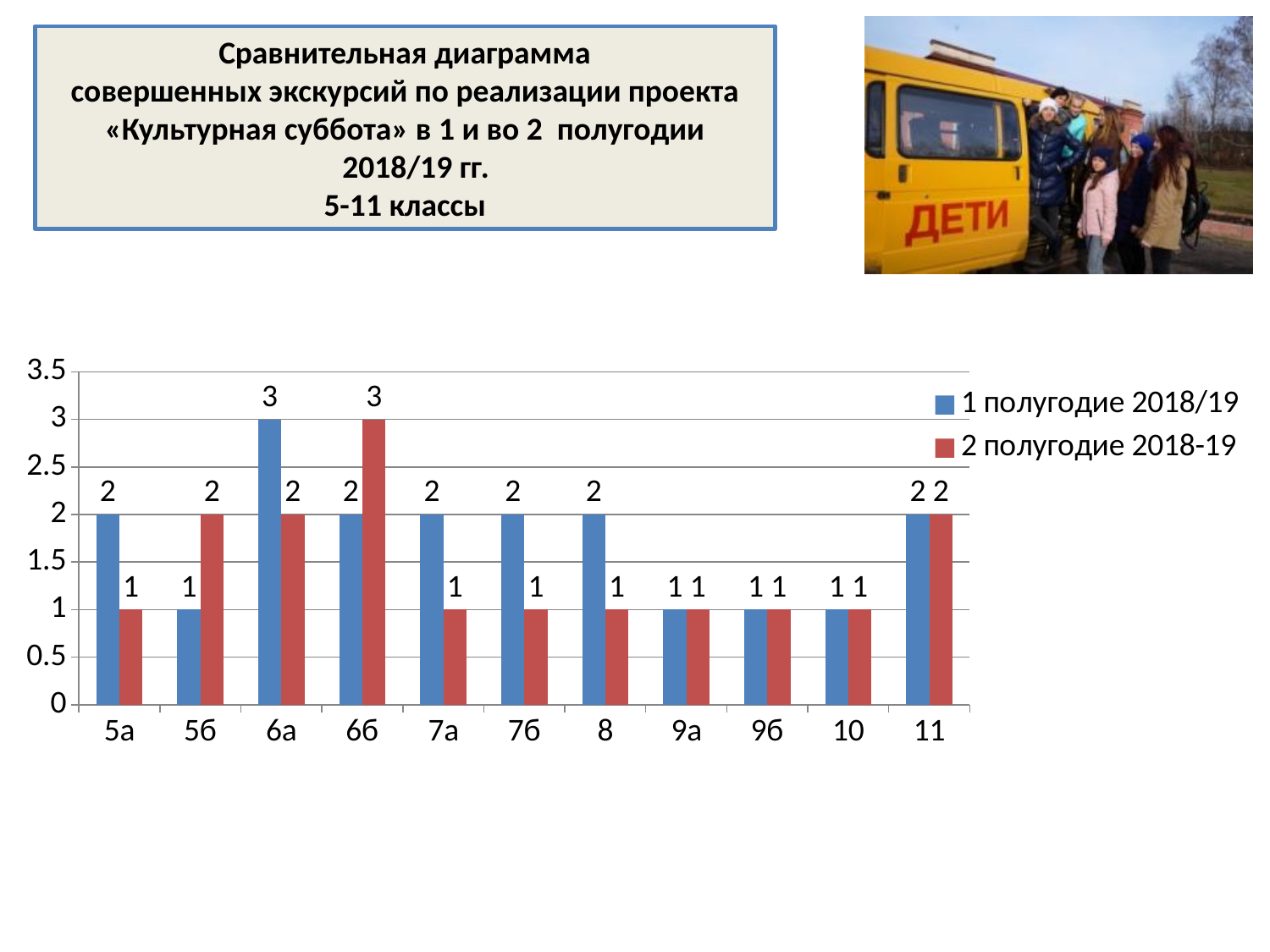
Is the value for 6а in the series "1 полугодие 2018/19" greater or less than 2.5? greater What kind of chart is shown on the slide? bar chart Which category has the highest value in the series "2 полугодие 2018-19"? 6б What is the value for 6а in the series "1 полугодие 2018/19"? 3 What is the total of the two series values for 11? 4 How many series does the legend list? 2 For 5б, which series has the larger value: "1 полугодие 2018/19" or "2 полугодие 2018-19"? 2 полугодие 2018-19 Which category has the highest value in the series "1 полугодие 2018/19"? 6а What is the value for 6б in the series "2 полугодие 2018-19"? 3 How many categories are shown on the x axis? 11 What is the value for 5б in the series "1 полугодие 2018/19"? 1 What is the difference between the "1 полугодие 2018/19" and "2 полугодие 2018-19" values for 5а? 1